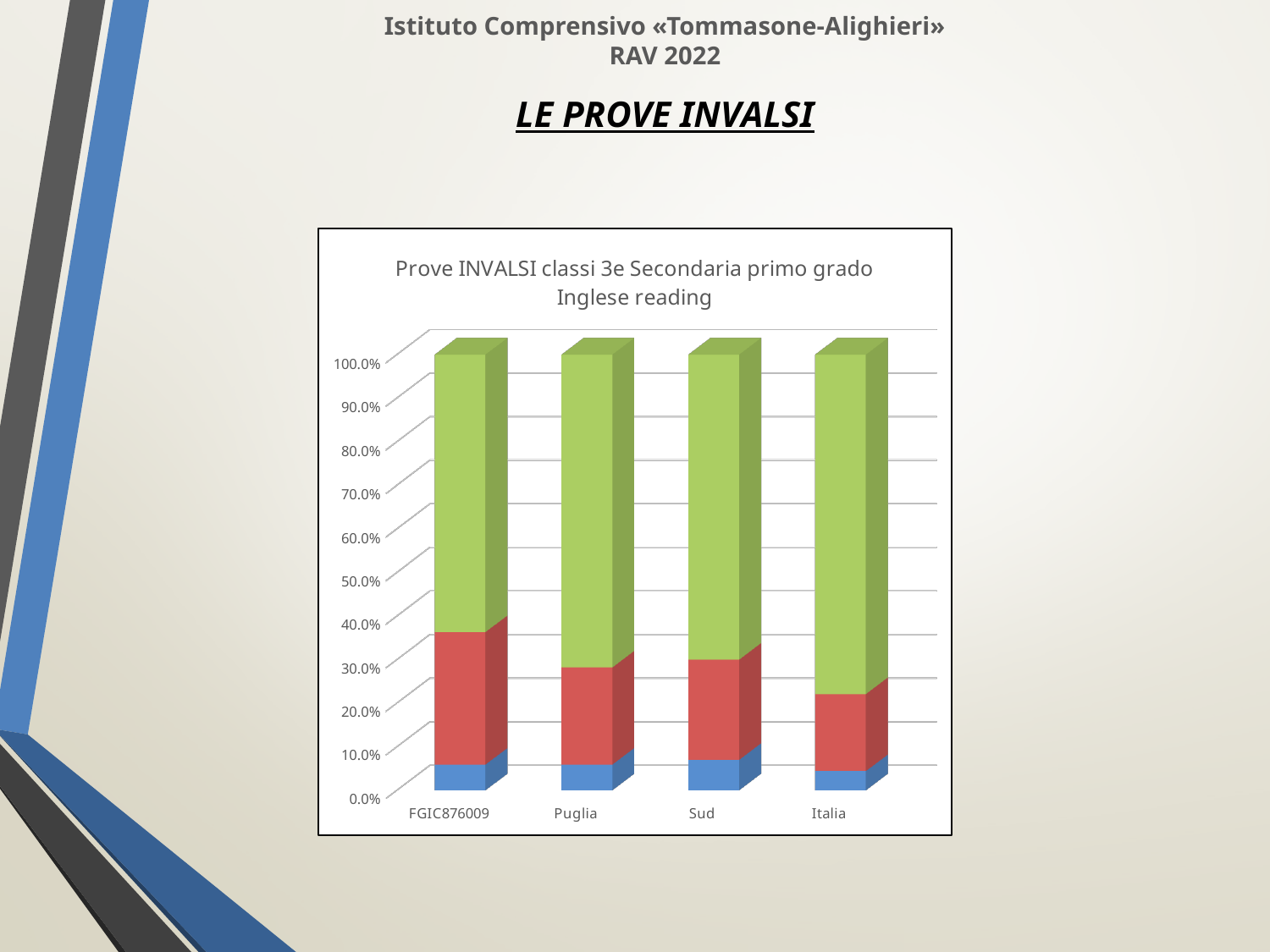
Is the top of the red segment for Italia greater or less than 30%? less Is the top of the red segment for Puglia greater or less than 40%? less What kind of chart is shown on the slide? Stacked bar chart Is the top of the red segment for FGIC876009 greater or less than 30%? greater What is the title of the chart? Prove INVALSI classi 3e Secondaria primo grado Inglese reading Which category has the largest red segment? FGIC876009 What is the total height of the stacked bar for Puglia? 100.0% How many categories are shown on the x axis of the chart? 4 Which category has the largest green segment? Italia Is the red segment larger for FGIC876009 or for Italia? FGIC876009 How many coloured segments make up each stacked bar? 3